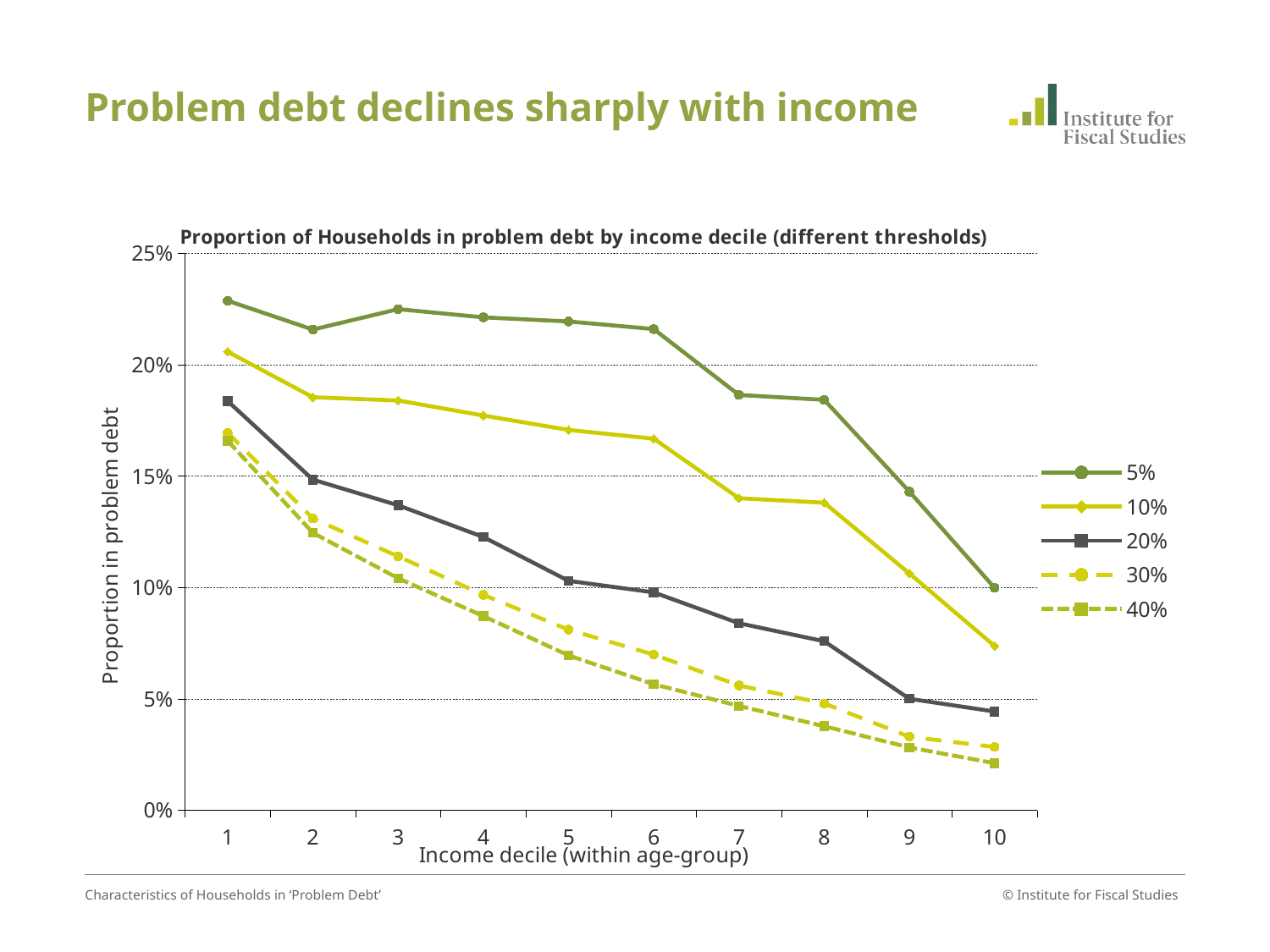
Do the proportions in problem debt rise or fall as income decile increases? Fall At income decile 5, which is larger: the 20% series or the 30% series? 20% Is the value for the 20% series at income decile 1 greater or less than 15%? greater Is the value for the 5% series at income decile 1 greater or less than 20%? greater How many income deciles are plotted along the x axis? 10 Which series has the lowest value at income decile 10? 40% What is the title of the chart? Proportion of Households in problem debt by income decile (different thresholds) Is the value for the 10% series at income decile 10 greater or less than 10%? less How many series does the legend list? 5 Which series has the highest value at income decile 1? 5% What type of chart is shown on the slide? Line chart